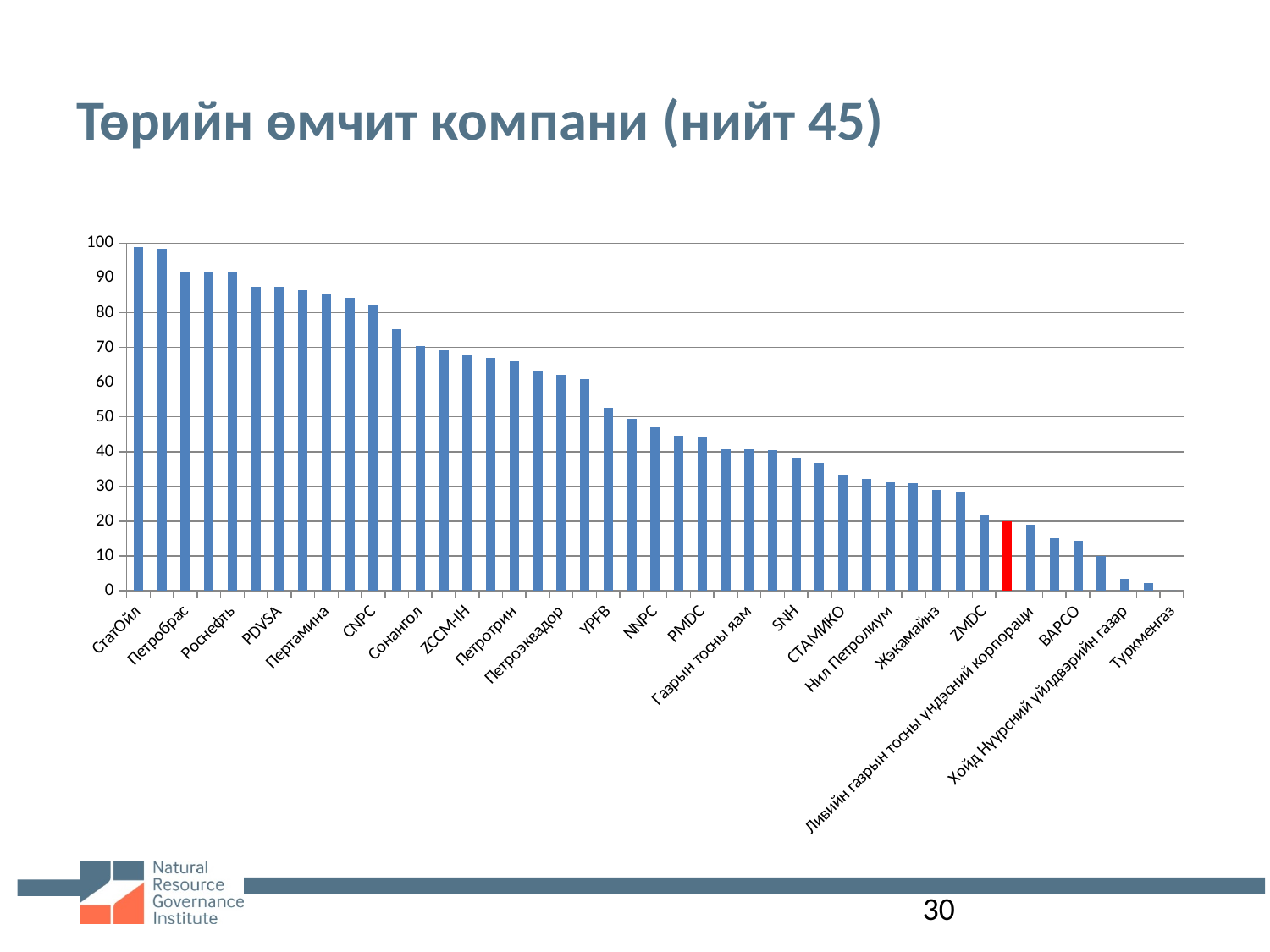
How many companies (bars) are plotted in the chart? 45 What kind of chart is shown on the slide? bar chart Which company has the highest value in the chart? СтатОйл Is the value for SNH greater or less than 40? less Is the value for СтатОйл greater or less than 90? greater Is the value for YPFB greater or less than 50? greater What is the title of the chart on the slide? Төрийн өмчит компани (нийт 45) Which has the larger value, PDVSA or NNPC? PDVSA Do the values rise or fall moving from left to right along the x axis? fall What colour is the single highlighted bar that differs from the others? red